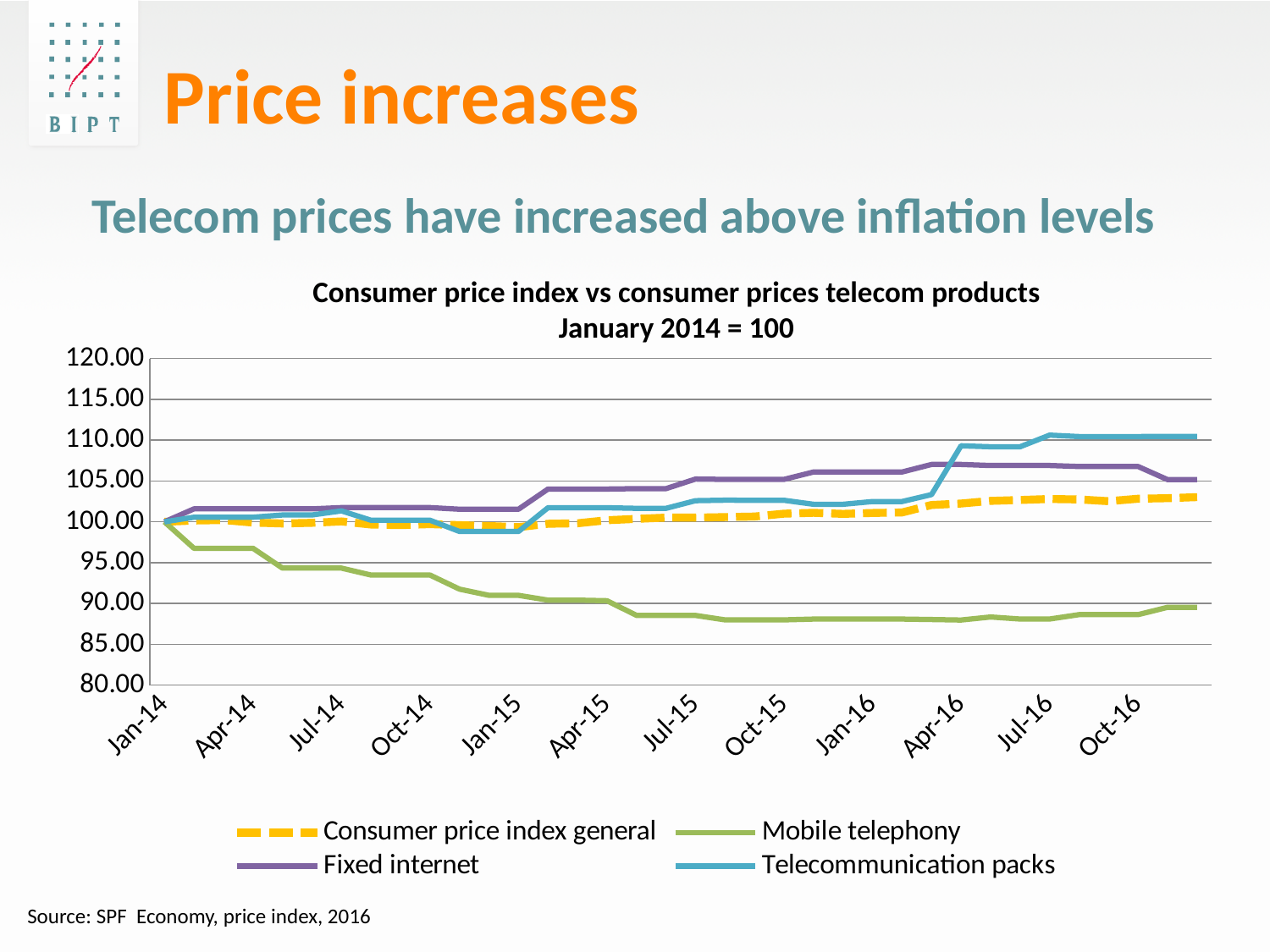
Does the Mobile telephony line rise or fall from Jan-14 to Oct-16? Fall How many series does the chart legend list? 4 Which series has the lowest value at Oct-16? Mobile telephony Is the value for Mobile telephony at Jul-15 greater or less than 90.00? less What kind of chart is shown on the slide? Line chart Is the value for Telecommunication packs at Oct-16 greater or less than 105.00? greater Does the Telecommunication packs line rise or fall from Jan-14 to Oct-16? Rise How many labelled dates are shown on the x axis? 12 What is the title of the chart? Consumer price index vs consumer prices telecom products January 2014 = 100 Which series is drawn with a dashed line? Consumer price index general At Jan-16, which is larger: Fixed internet or Mobile telephony? Fixed internet Which series has the highest value at Oct-16? Telecommunication packs